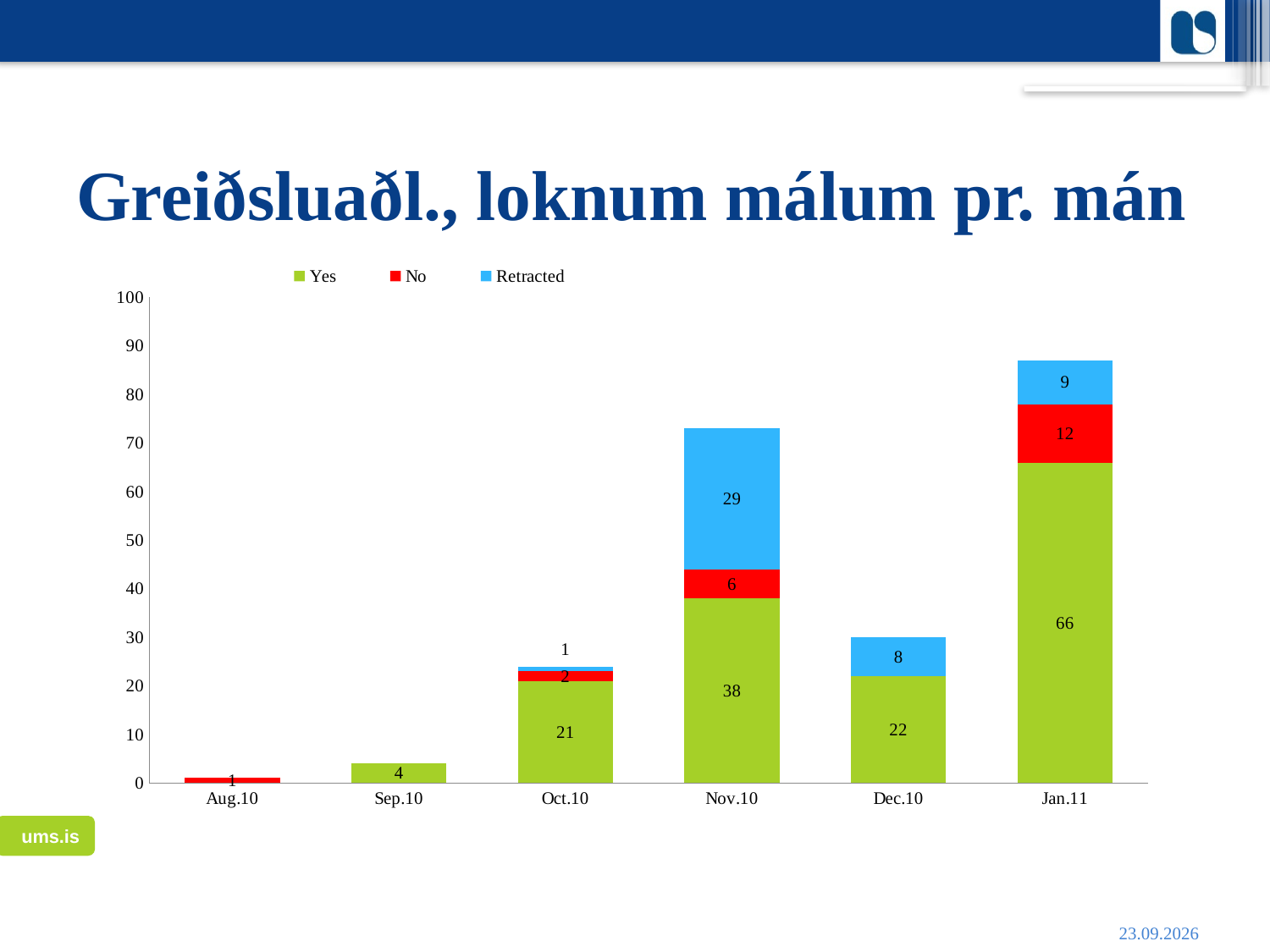
What is the Yes value for Sep.10? 4 How many series does the legend list? 3 What is the total of the stacked bar for Nov.10? 73 What kind of chart is shown on the slide? Stacked bar chart Which month has the highest Yes value? Jan.11 What is the Retracted value for Nov.10? 29 What is the No value for Jan.11? 12 What is the difference between the Yes values for Jan.11 and Dec.10? 44 What is the Yes value for Nov.10? 38 Is the Retracted value for Nov.10 or Jan.11 larger? Nov.10 What is the total of the stacked bar for Jan.11? 87 How many months are shown on the x axis? 6